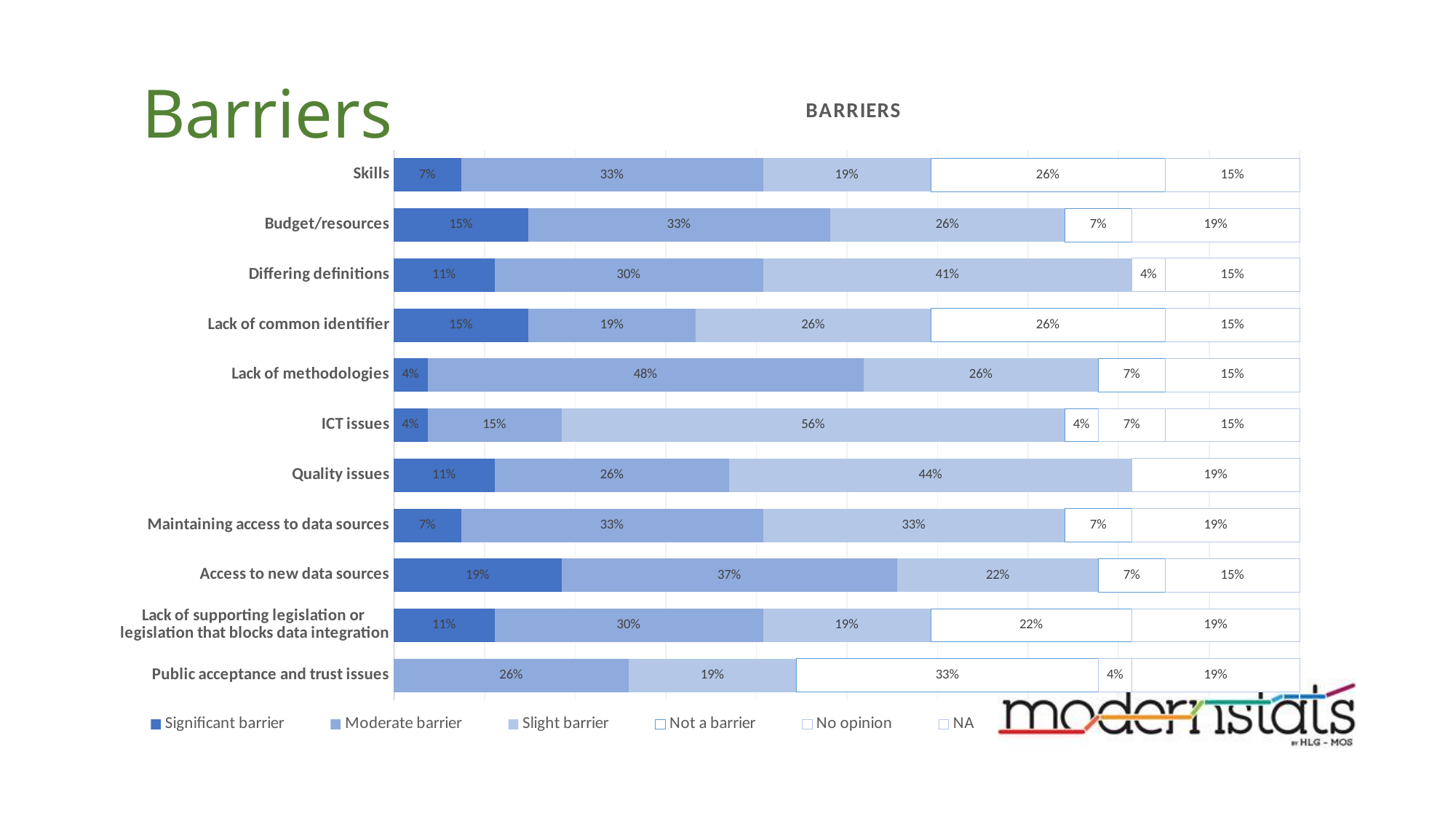
How many series does the legend of the BARRIERS chart list? 6 What is the Moderate barrier value for 'Lack of methodologies'? 48% Which category has the highest Slight barrier percentage? ICT issues Which has the larger Significant barrier value: 'Budget/resources' or 'Skills'? Budget/resources What kind of chart is shown on the slide? Stacked bar chart What percentage rated 'Access to new data sources' as a Significant barrier? 19% What is the Slight barrier value for 'Quality issues'? 44% What is the title of the chart? BARRIERS How many barrier categories are plotted in the BARRIERS chart? 11 For 'Skills', how much larger is the Moderate barrier value than the Significant barrier value? 26 percentage points Which category has the highest Significant barrier percentage? Access to new data sources What is the Slight barrier value for 'ICT issues'? 56%